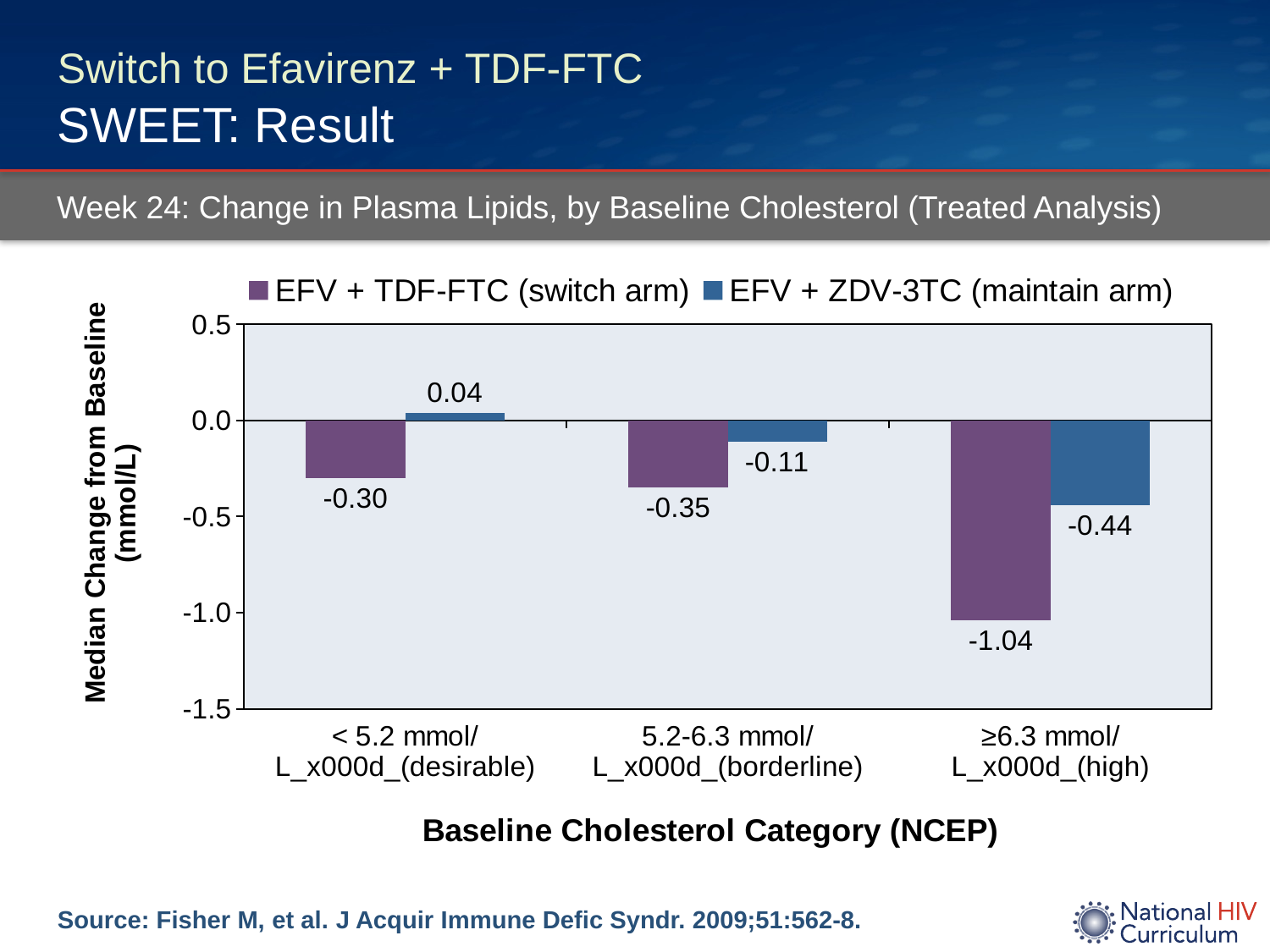
What is the median change from baseline for the EFV + TDF-FTC (switch arm) in the < 5.2 mmol/L (desirable) category? -0.30 Is the value for the switch arm in the ≥6.3 mmol/L (high) category greater or less than -1.0? less What kind of chart is shown on the slide? Bar chart How many baseline cholesterol categories are shown on the x axis? 3 What is the difference between the switch arm and maintain arm values in the ≥6.3 mmol/L (high) category? 0.60 Which baseline cholesterol category has the highest value for the EFV + ZDV-3TC (maintain arm)? < 5.2 mmol/L (desirable) In the 5.2-6.3 mmol/L (borderline) category, which arm has the larger decrease from baseline? EFV + TDF-FTC (switch arm) Which baseline cholesterol category shows the largest decrease for the EFV + TDF-FTC (switch arm)? ≥6.3 mmol/L (high) How many series does the legend list? 2 What is the median change from baseline for the EFV + ZDV-3TC (maintain arm) in the ≥6.3 mmol/L (high) category? -0.44 What is the label of the y axis? Median Change from Baseline (mmol/L) What is the value for the EFV + ZDV-3TC (maintain arm) in the 5.2-6.3 mmol/L (borderline) category? -0.11